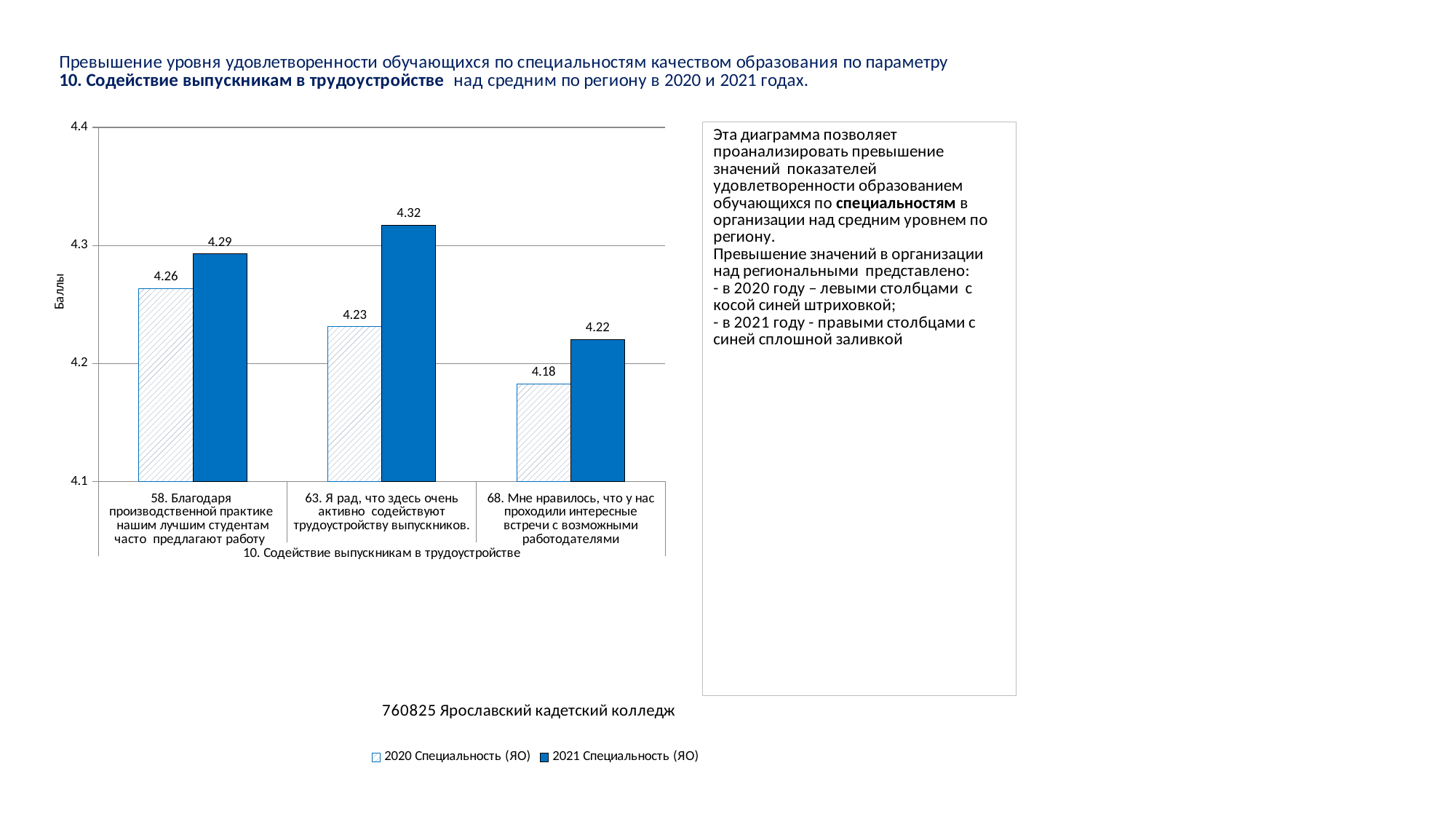
What is the 2021 Специальность (ЯО) value for category "63. Я рад, что здесь очень активно содействуют трудоустройству выпускников."? 4.32 Which category has the lowest 2020 Специальность (ЯО) value? 68. Мне нравилось, что у нас проходили интересные встречи с возможными работодателями What is the label of the vertical axis of the chart? Баллы How many categories are shown on the x axis of the chart? 3 Which category has the highest 2021 Специальность (ЯО) value? 63. Я рад, что здесь очень активно содействуют трудоустройству выпускников. How many series does the chart legend list? 2 What is the 2020 Специальность (ЯО) value for category "58. Благодаря производственной практике нашим лучшим студентам часто предлагают работу"? 4.26 Is the 2020 Специальность (ЯО) value for category "68. Мне нравилось, что у нас проходили интересные встречи с возможными работодателями" greater or less than 4.2? less What kind of chart is shown on the slide? bar chart What is the 2020 Специальность (ЯО) value for category "68. Мне нравилось, что у нас проходили интересные встречи с возможными работодателями"? 4.18 What is the difference between the 2021 and 2020 values for category "63. Я рад, что здесь очень активно содействуют трудоустройству выпускников."? 0.09 Which is larger for category "58. Благодаря производственной практике нашим лучшим студентам часто предлагают работу": the 2020 value or the 2021 value? 2021